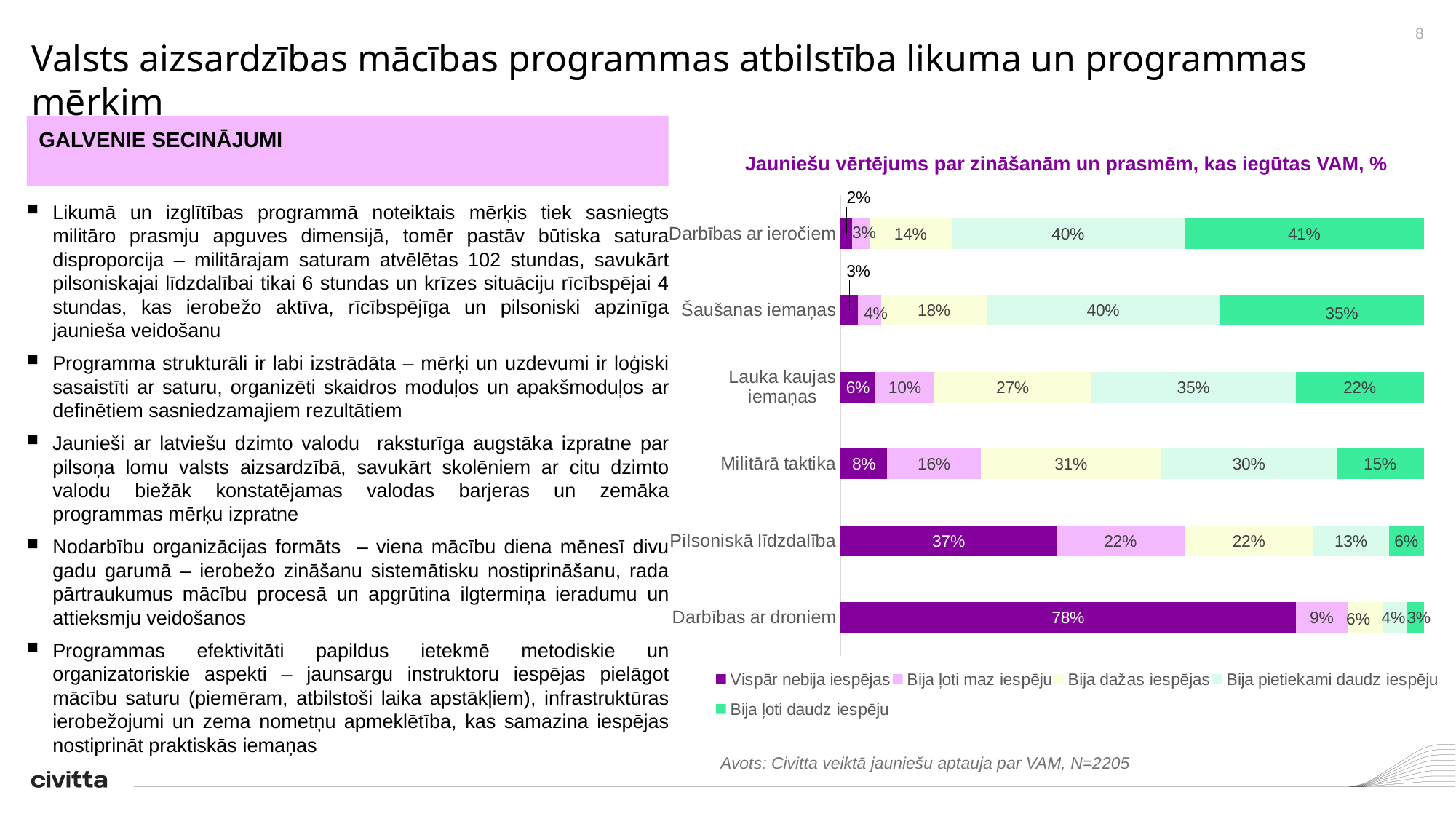
What is the value of 'Bija dažas iespējas' for 'Militārā taktika'? 31% Which category has the lowest value for 'Bija ļoti daudz iespēju'? Darbības ar droniem What is the value of 'Bija ļoti daudz iespēju' for 'Darbības ar ieročiem'? 41% What type of chart is shown on the slide? Stacked bar chart Which is larger: the 'Bija ļoti daudz iespēju' value for 'Šaušanas iemaņas' or for 'Lauka kaujas iemaņas'? Šaušanas iemaņas What is the difference between the 'Vispār nebija iespējas' values for 'Darbības ar droniem' and 'Pilsoniskā līdzdalība'? 41% What is the value of 'Bija pietiekami daudz iespēju' for 'Lauka kaujas iemaņas'? 35% Which category has the highest value for 'Vispār nebija iespējas'? Darbības ar droniem What is the title of the chart? Jauniešu vērtējums par zināšanām un prasmēm, kas iegūtas VAM, % How many series does the legend list? 5 What is the value of 'Vispār nebija iespējas' for 'Darbības ar droniem'? 78% How many categories are shown on the chart? 6